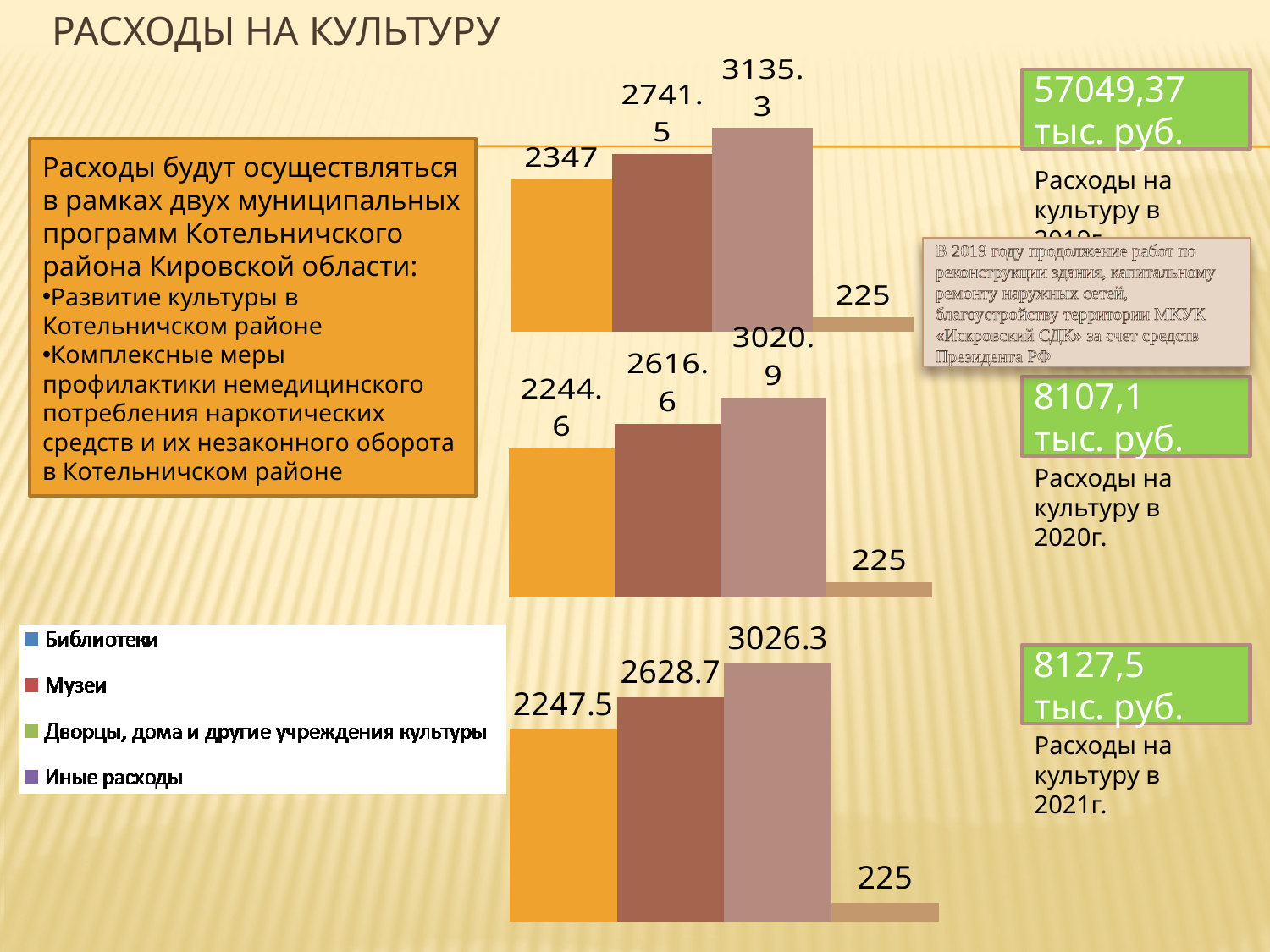
How many entries does the legend on the slide list? 4 In the bottom chart, what is the value of the second bar? 2628.7 In the middle chart, what is the value of the first bar? 2244.6 What type of chart is used on this slide? bar chart In the top chart, what is the value of the shortest bar? 225 How many bars does the top chart contain? 4 In the middle chart, what is the difference between the third bar (3020.9) and the second bar (2616.6)? 404.3 In the middle chart, what is the value of the third bar? 3020.9 In the top chart, what is the difference between the second bar (2741.5) and the first bar (2347)? 394.5 In the top chart, what is the value of the tallest bar? 3135.3 Which is larger: the second bar of the bottom chart (2628.7) or the second bar of the middle chart (2616.6)? the second bar of the bottom chart (2628.7) In the bottom chart, what is the difference between the first bar (2247.5) and the last bar (225)? 2022.5